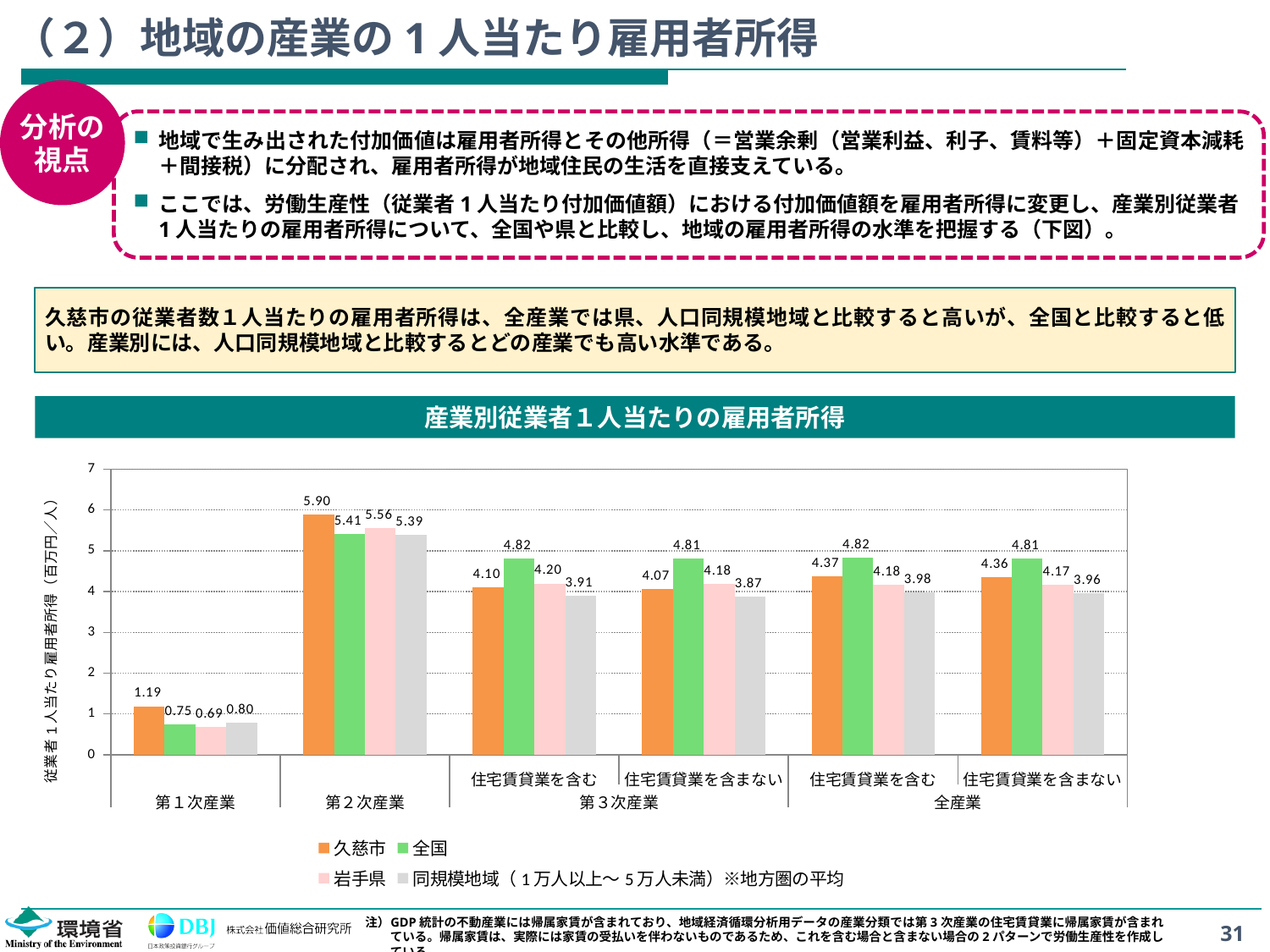
縦軸のラベルは何ですか？ 従業者１人当たり雇用者所得（百万円／人） 第２次産業における久慈市と全国の値の差はいくらですか？ 0.49 久慈市の系列で最も値が高い産業区分はどれですか？ 第２次産業 第３次産業（住宅賃貸業を含む）における全国の値はいくらですか？ 4.82 第３次産業（住宅賃貸業を含まない）における同規模地域の値は4より大きいですか、小さいですか？ 小さい このグラフの種類は何ですか？ 棒グラフ 第２次産業における岩手県の値はいくらですか？ 5.56 凡例にはいくつの系列が示されていますか？ 4 第１次産業における久慈市の従業者１人当たり雇用者所得はいくらですか？ 1.19 第１次産業で最も値が低い系列はどれですか？ 岩手県 全産業（住宅賃貸業を含まない）における同規模地域の値はいくらですか？ 3.96 全産業（住宅賃貸業を含む）では、久慈市と全国のどちらの値が大きいですか？ 全国